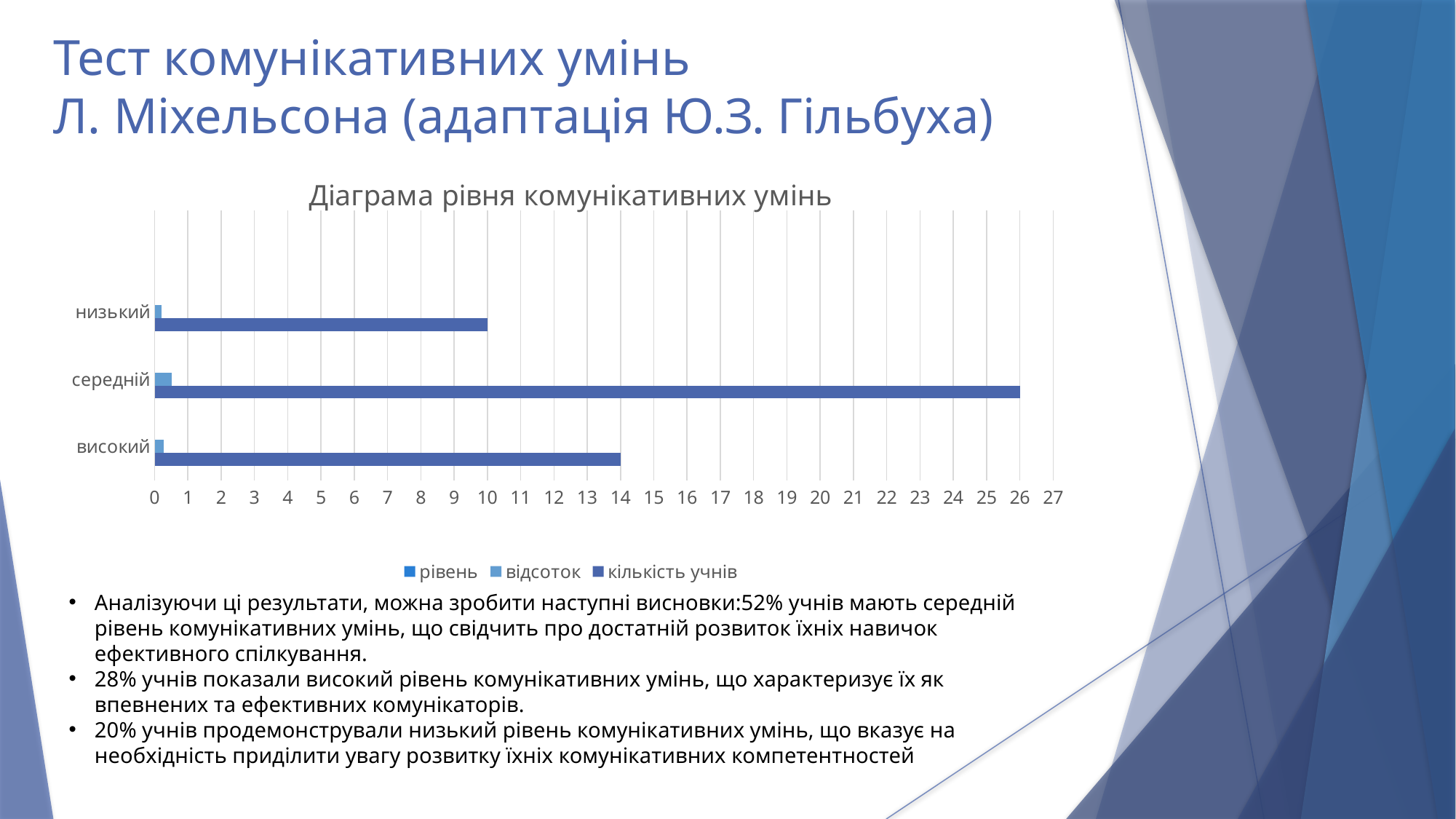
What is the value of 'кількість учнів' for the category 'середній'? 26 What is the difference between the 'кількість учнів' values for 'середній' and 'високий'? 12 Which category has the lowest value for 'кількість учнів'? низький Is the 'кількість учнів' value for 'середній' greater or less than 20? greater Which has a larger 'кількість учнів' value: 'високий' or 'низький'? високий How many series does the chart legend list? 3 Which category has the highest value for 'кількість учнів'? середній How many categories are shown on the vertical axis of the chart? 3 What is the value of 'кількість учнів' for the category 'низький'? 10 What is the value of 'кількість учнів' for the category 'високий'? 14 What is the title of the chart? Діаграма рівня комунікативних умінь What kind of chart is shown on the slide? bar chart